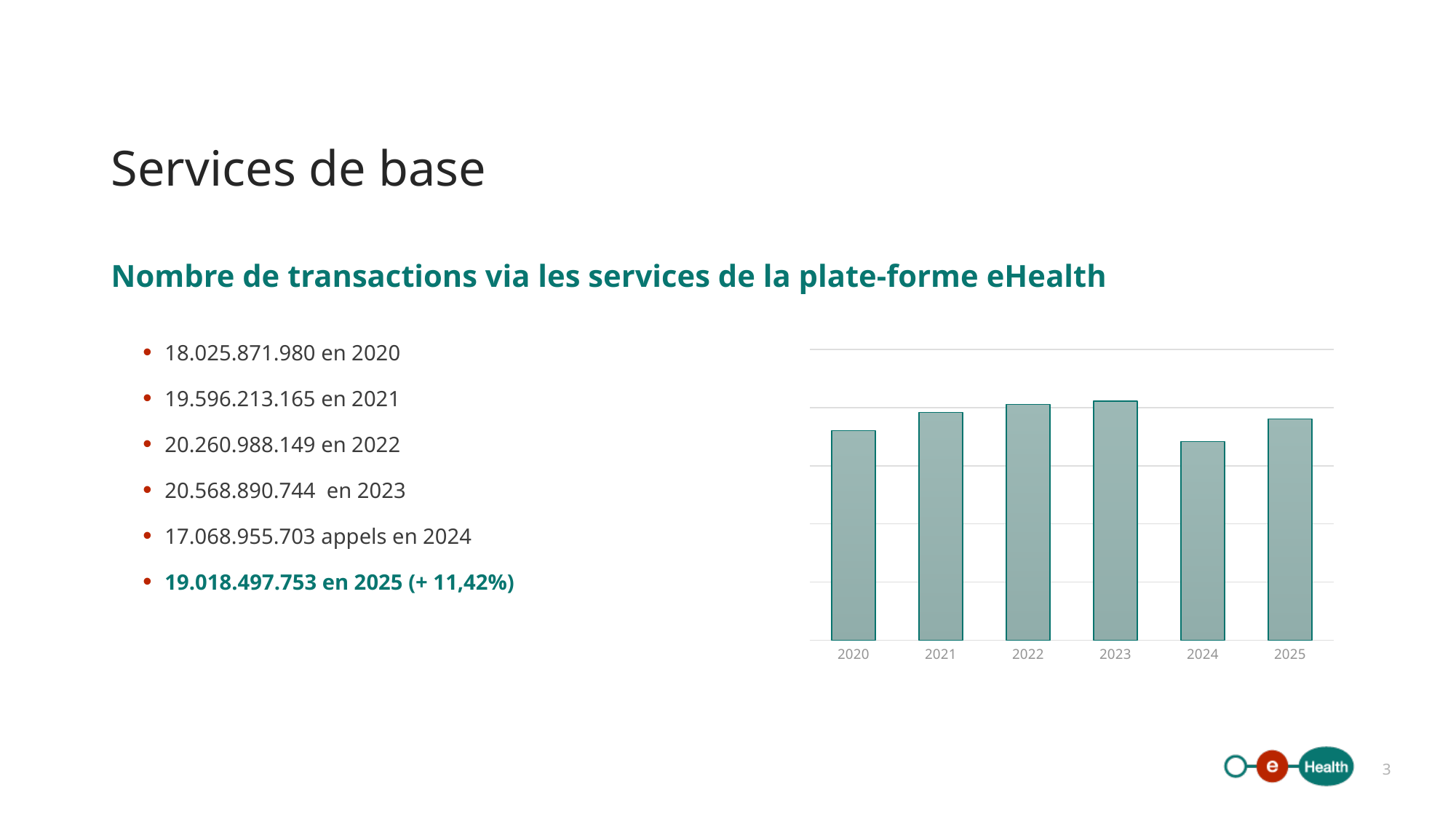
What is the difference between the 2023 value and the 2024 value? 3.499.935.041 Do the bars rise or fall from 2020 to 2023? rise Which year has the highest bar in the chart? 2023 How many years are plotted in the bar chart? 6 According to the slide, how many transactions were there in 2020? 18.025.871.980 What kind of chart is shown on the slide? bar chart Which year has the lowest bar in the chart? 2024 Is the bar for 2022 taller or shorter than the bar for 2020? taller What percentage change is given for 2025 on the slide? + 11,42% Which is larger, the value for 2021 or the value for 2025? 2021 According to the slide, how many transactions were there in 2023? 20.568.890.744 According to the slide, how many transactions were there in 2025? 19.018.497.753